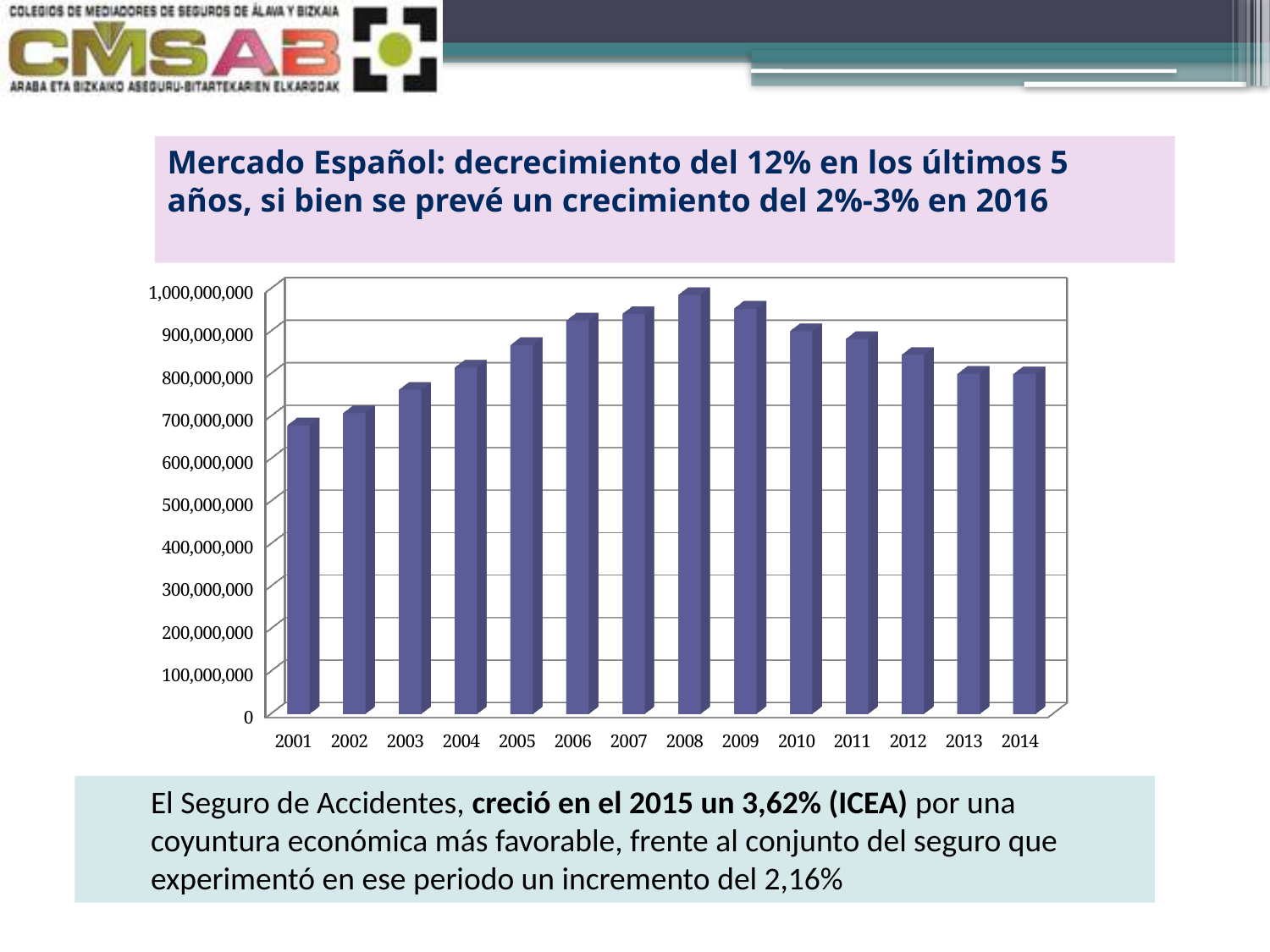
Do the values rise or fall from 2001 to 2008? rise Is the value for 2014 greater or less than 900,000,000? less How many years are plotted on the x axis of the chart? 14 Do the values rise or fall from 2008 to 2014? fall Which is larger, the value for 2009 or the value for 2010? 2009 Which year has the lowest bar in the chart? 2001 Is the value for 2008 greater or less than 900,000,000? greater Is the value for 2001 greater or less than 600,000,000? greater What kind of chart is shown on the slide? bar chart Which is larger, the value for 2003 or the value for 2012? 2012 Which year has the highest bar in the chart? 2008